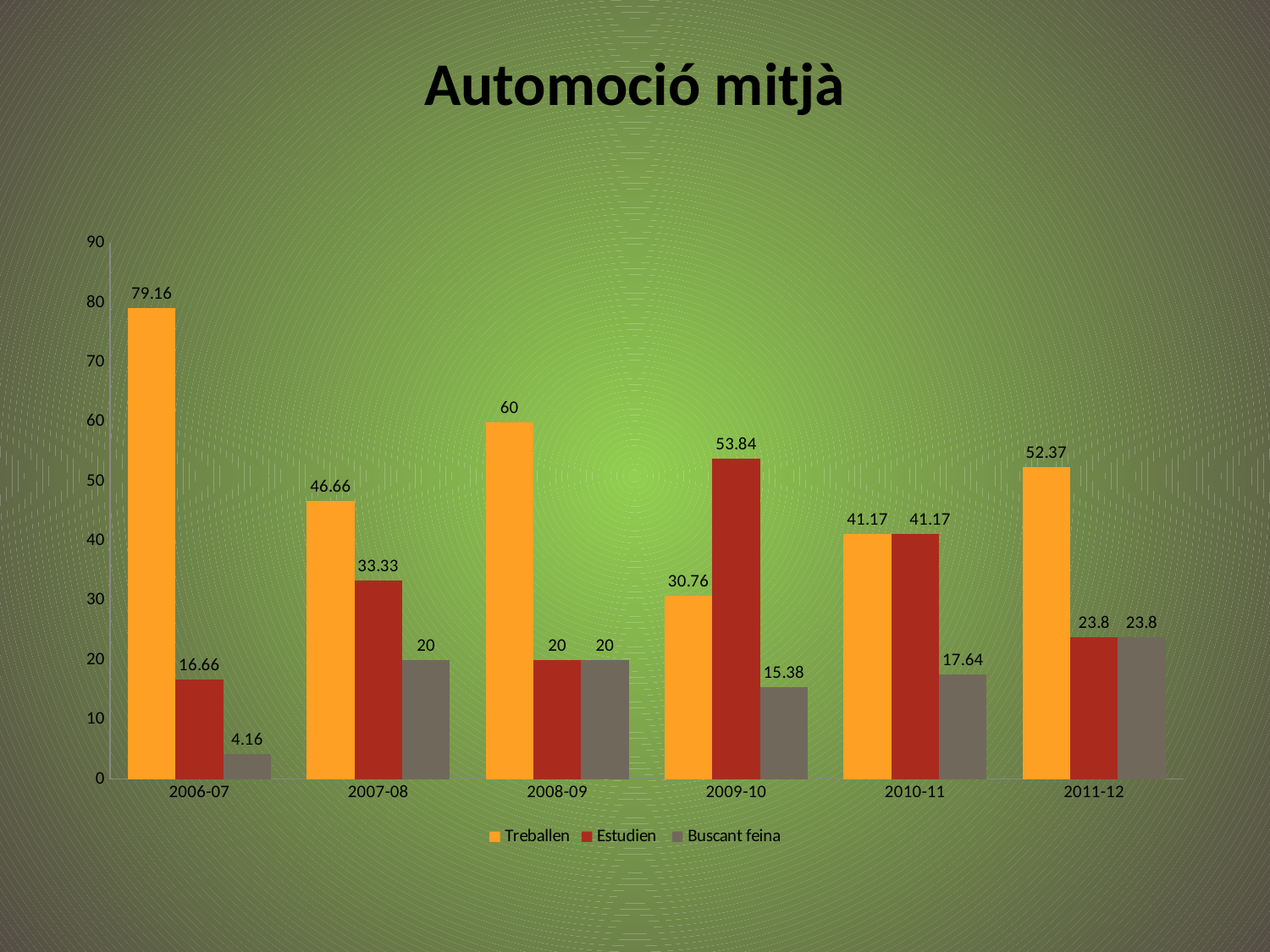
What is the difference between the Treballen and Estudien values in 2007-08? 13.33 Which year has the lowest Buscant feina value? 2006-07 What kind of chart is shown on the slide? bar chart What is the value for Estudien in 2009-10? 53.84 What is the value for Buscant feina in 2010-11? 17.64 Is the value for Treballen in 2008-09 greater or less than 50? greater Which is larger in 2009-10, Treballen or Estudien? Estudien Which year has the highest Treballen value? 2006-07 How many year categories are shown on the x axis? 6 What is the value for Treballen in 2006-07? 79.16 How many series does the legend list? 3 What is the title of the chart? Automoció mitjà